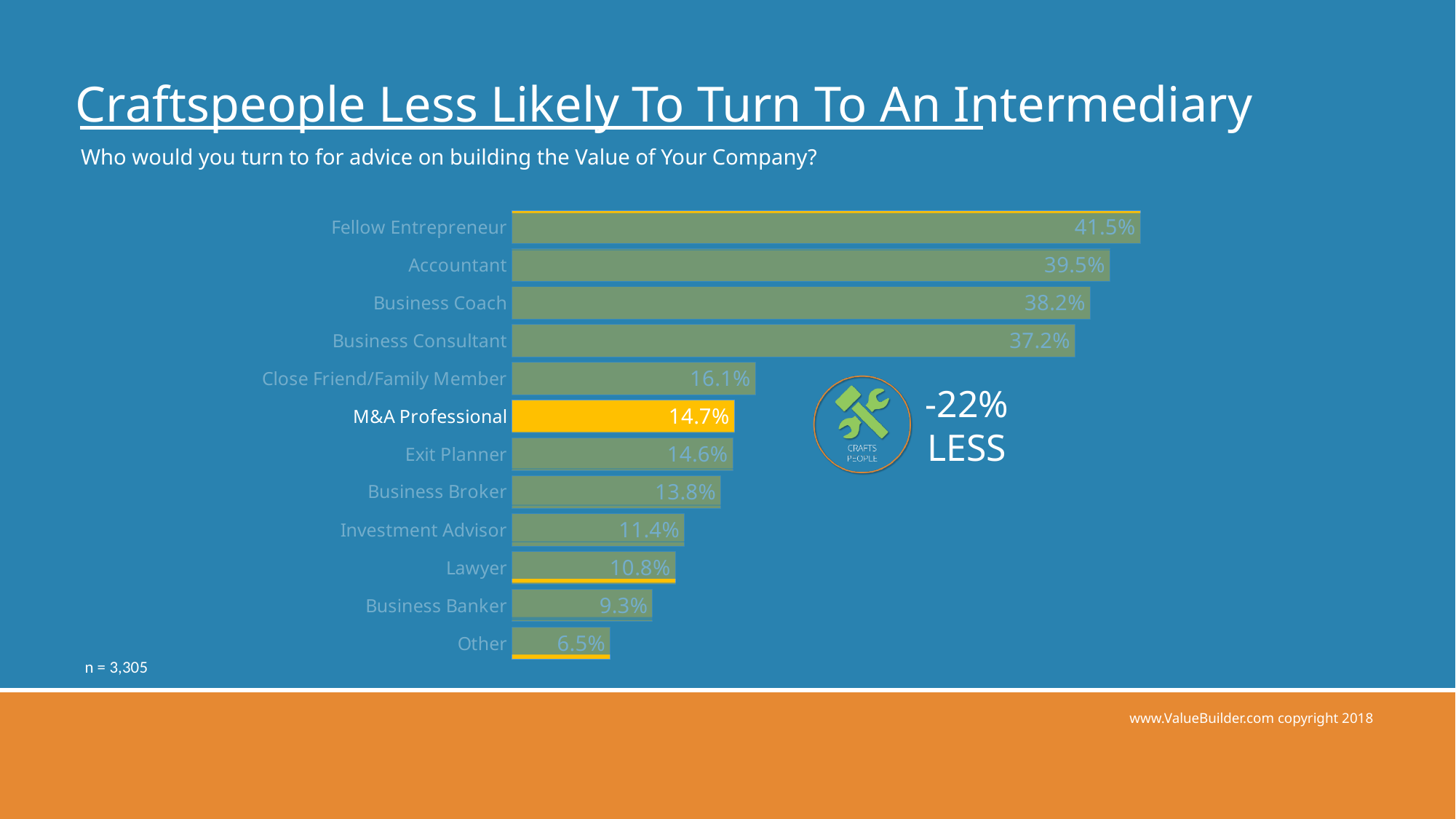
Which has a larger value, Business Broker or Lawyer? Business Broker What percentage of respondents said they would turn to a Fellow Entrepreneur? 41.5% What percentage is shown for Business Banker? 9.3% What type of chart is shown on the slide? Bar chart Which bar in the chart is highlighted in a different colour (yellow) from the others? M&A Professional What is the value shown for M&A Professional? 14.7% Which category has the highest value in the chart? Fellow Entrepreneur How many categories are shown in the chart? 12 What is the value for Close Friend/Family Member? 16.1% Which category has the lowest value in the chart? Other What is the difference in percentage points between Fellow Entrepreneur and Accountant? 2.0 percentage points What is the difference in percentage points between Close Friend/Family Member and M&A Professional? 1.4 percentage points